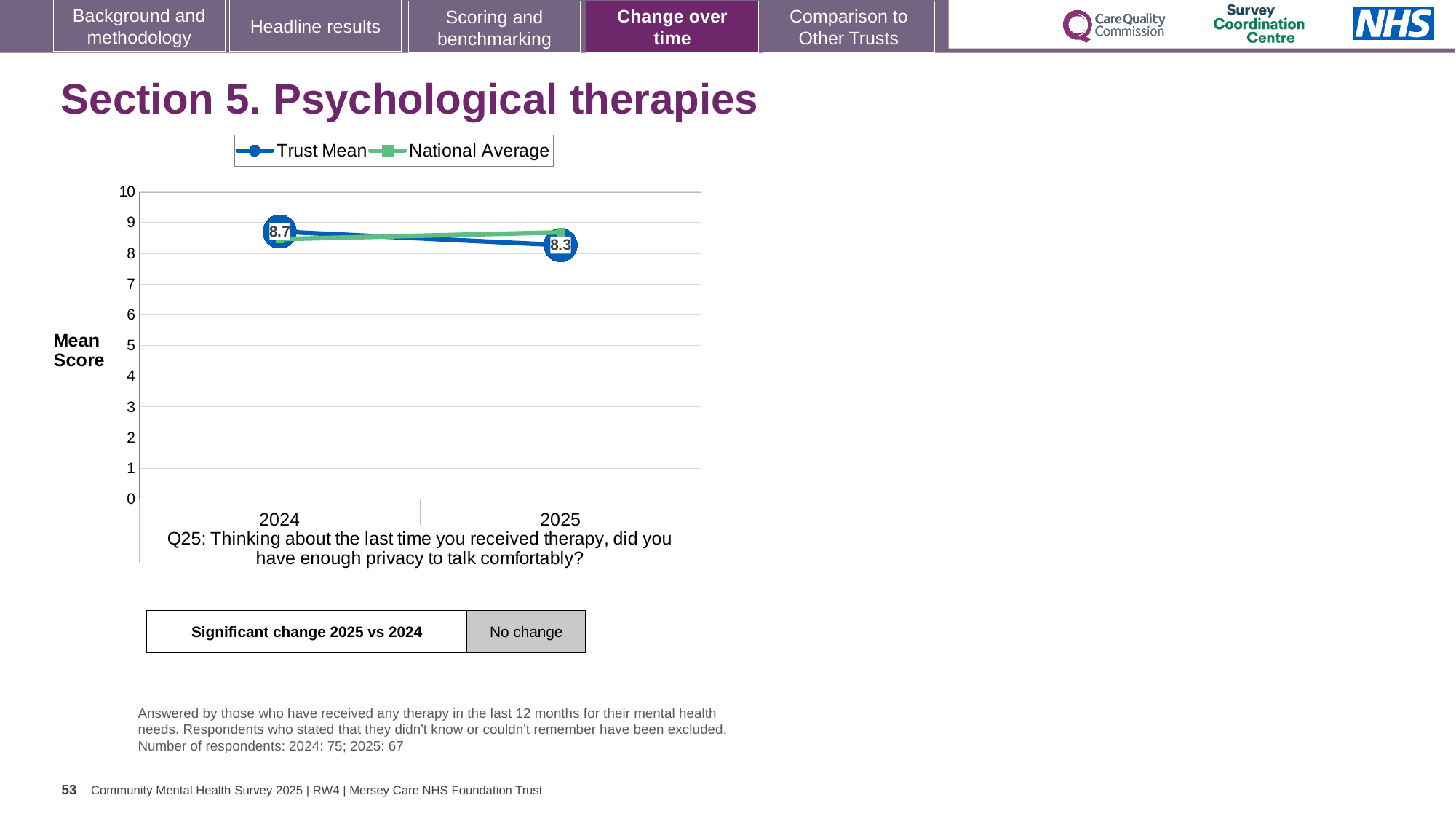
How many series does the legend list? 2 Which year has the higher Trust Mean score, 2024 or 2025? 2024 In which year is the Trust Mean score highest? 2024 What is the Trust Mean score for 2025? 8.3 What kind of chart is shown on the slide? line chart Is the National Average value for 2025 greater or less than 8? greater What is the difference between the Trust Mean scores for 2024 and 2025? 0.4 In 2025, which is higher, the Trust Mean or the National Average? National Average What is the Trust Mean score for 2024? 8.7 Is the National Average value for 2024 greater or less than 9? less How many years are plotted on the x axis? 2 Does the Trust Mean rise or fall from 2024 to 2025? fall